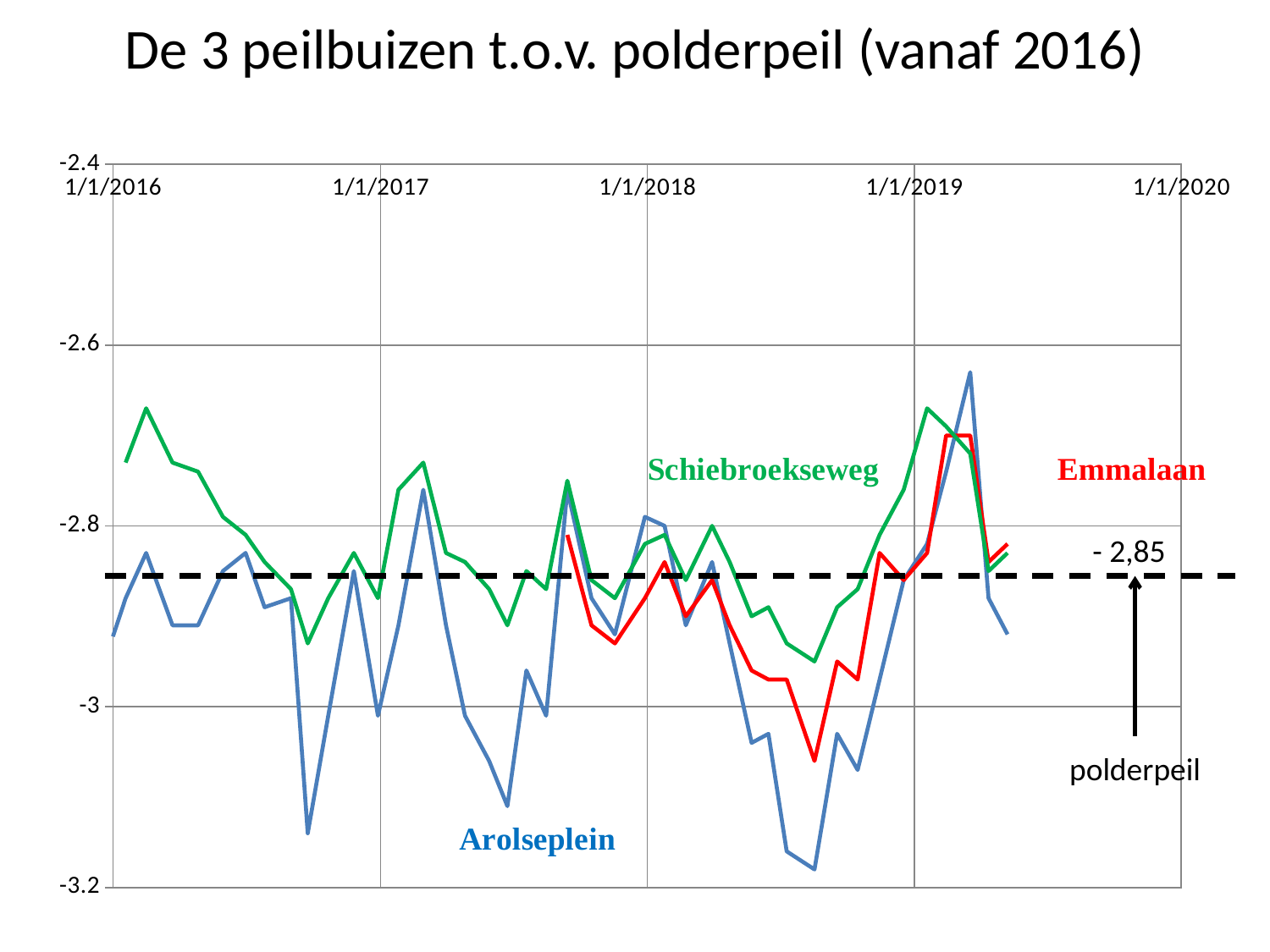
What value does the dashed horizontal line (polderpeil) represent? - 2,85 Is the lowest value of the Arolseplein series greater or less than -3? less What is the title of the chart? De 3 peilbuizen t.o.v. polderpeil (vanaf 2016) Does the Emmalaan series rise or fall between its lowest point in mid-2018 and 1/1/2019? rise Is the highest value of the Schiebroekseweg series greater or less than -2.8? greater What kind of chart is shown on the slide? line chart Which series starts latest along the x axis? Emmalaan Is the lowest value of the Emmalaan series greater or less than -3? less Which series reaches the lowest value on the chart? Arolseplein How many series are plotted on the chart? 3